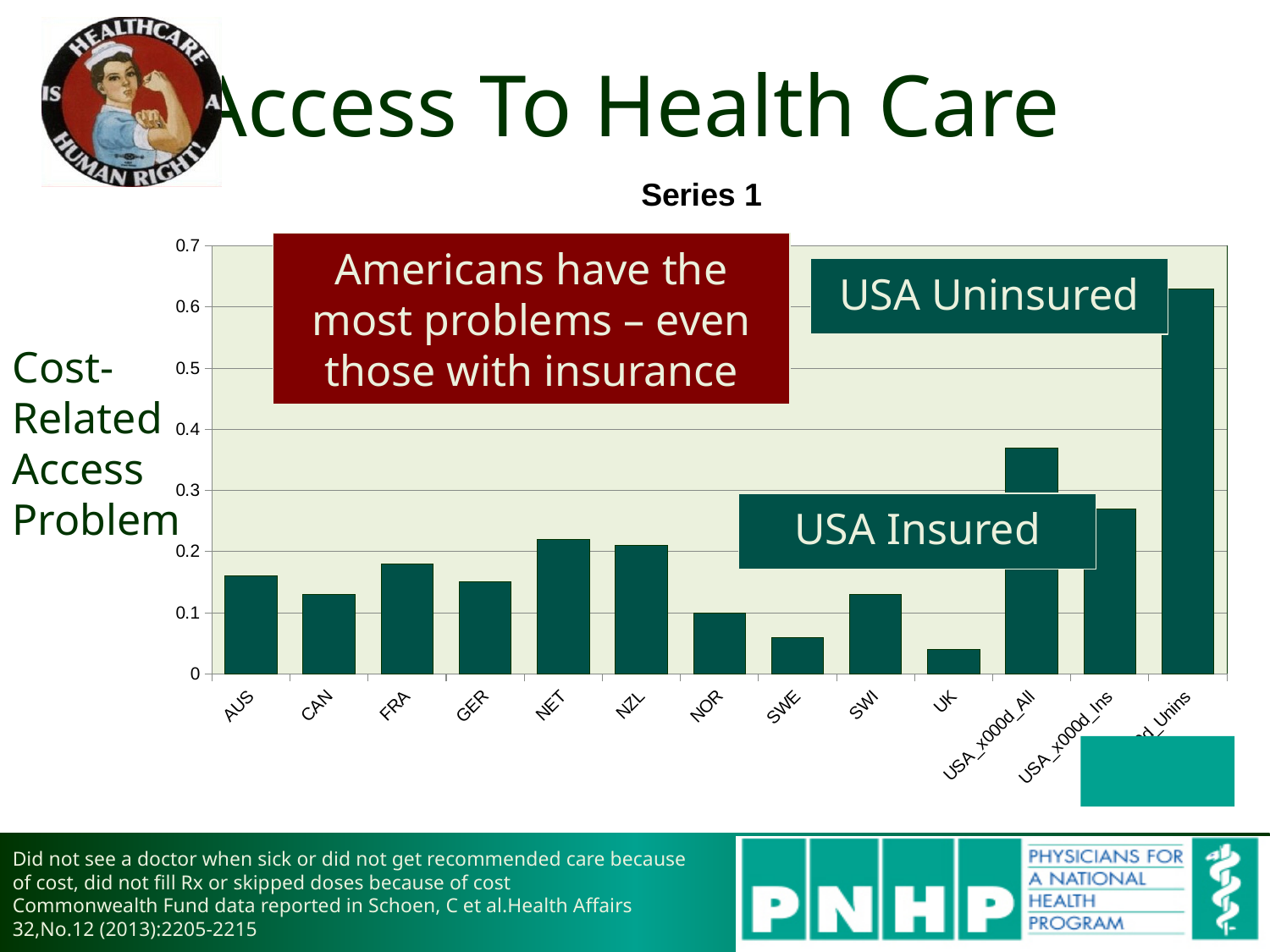
Is the value for SWE greater or less than 0.1? less How many categories are plotted along the x axis of the chart? 13 Is the value for UK greater or less than 0.1? less Is the value for NET greater or less than 0.2? greater What is the title shown above the chart? Series 1 Which category has the highest bar in the chart? USA Uninsured Which has the larger value, FRA or GER? FRA Which category has the lowest bar in the chart? UK What kind of chart is shown on the slide? bar chart Which has the larger value, USA_x000d_All or USA_x000d_Ins? USA_x000d_All What label appears to the left of the y axis of the chart? Cost-Related Access Problem